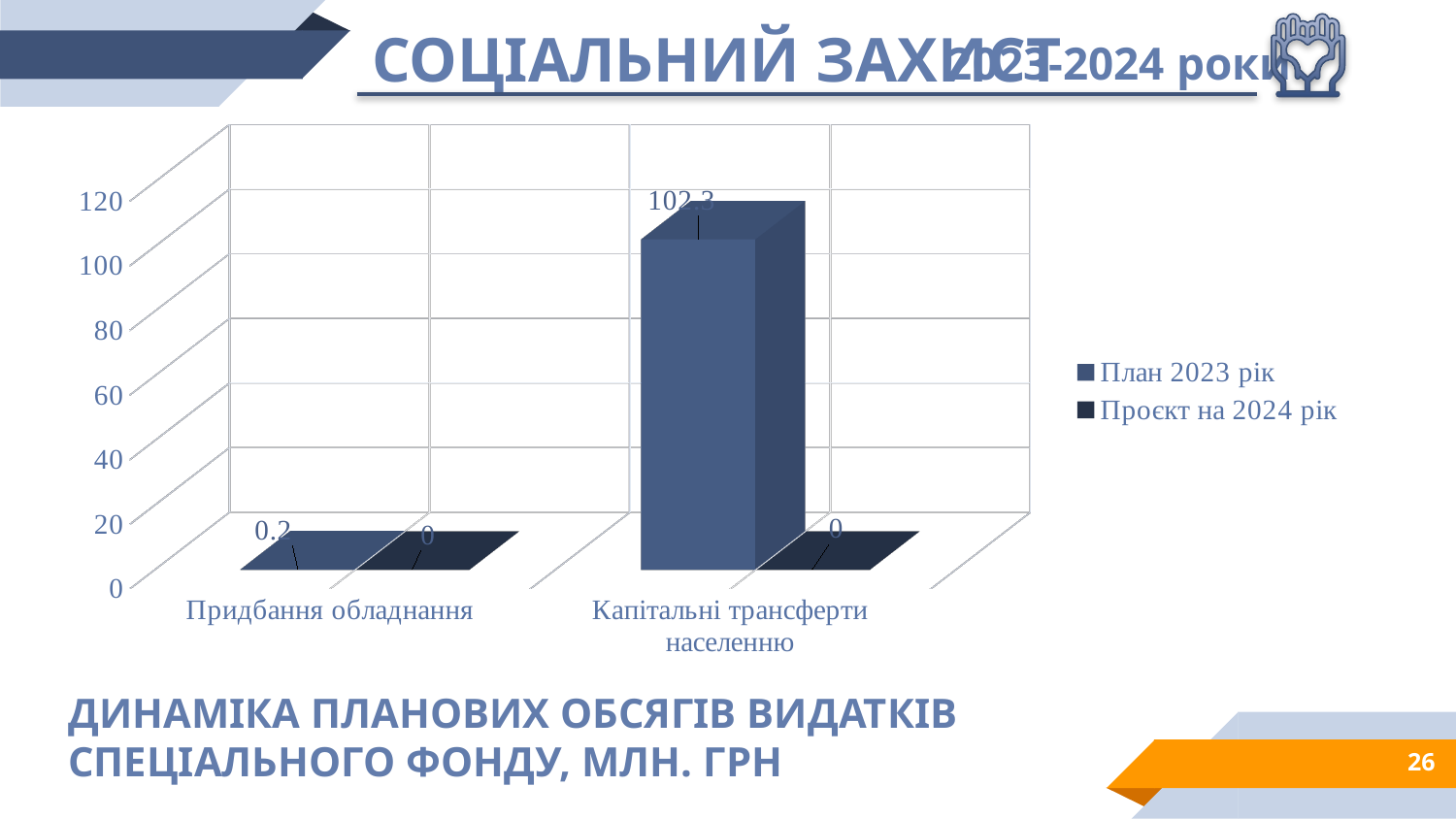
What is the value for "Капітальні трансферти населенню" in the "Проєкт на 2024 рік" series? 0 How many categories are shown on the x axis of the chart? 2 What kind of chart is shown on the slide? bar chart How many series does the chart legend list? 2 What is the value for "Капітальні трансферти населенню" in the "План 2023 рік" series? 102.3 Which category has the highest value in the "План 2023 рік" series? Капітальні трансферти населенню Is the "План 2023 рік" value for "Капітальні трансферти населенню" greater or less than 100? greater Which is larger for "Капітальні трансферти населенню": the "План 2023 рік" value or the "Проєкт на 2024 рік" value? План 2023 рік What is the value for "Придбання обладнання" in the "Проєкт на 2024 рік" series? 0 What is the difference between the "План 2023 рік" values for "Капітальні трансферти населенню" and "Придбання обладнання"? 102.1 What is the value for "Придбання обладнання" in the "План 2023 рік" series? 0.2 Which category has the lowest value in the "План 2023 рік" series? Придбання обладнання